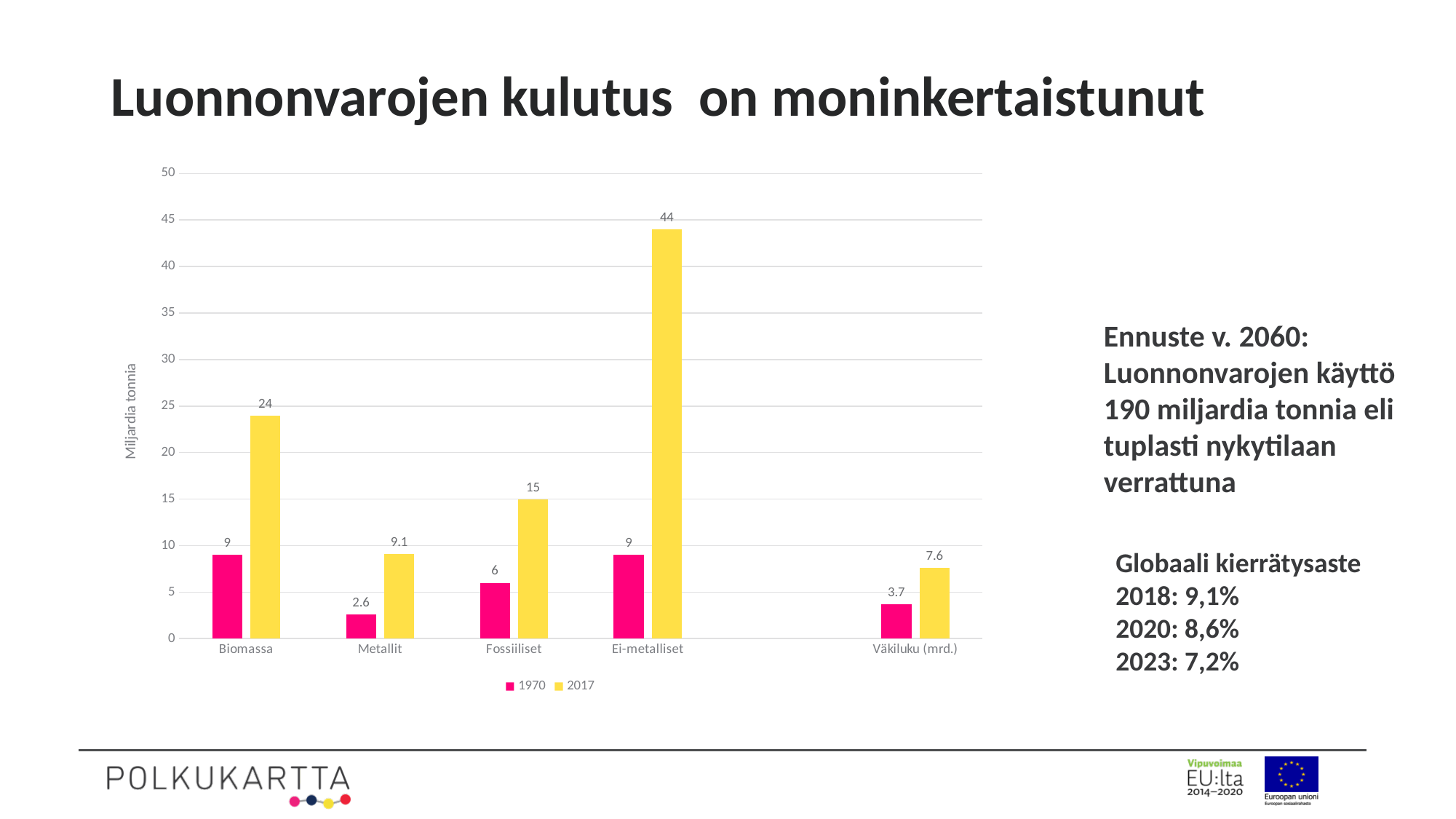
How many series does the legend list? 2 Is the 2017 value for Ei-metalliset greater or less than 40? greater Which is larger: the 2017 value for Fossiiliset or the 2017 value for Metallit? Fossiiliset How many categories are shown on the x axis? 5 What is the difference between the 2017 and 1970 values for Biomassa? 15 What is the label of the vertical axis? Miljardia tonnia Which category has the highest 2017 value? Ei-metalliset What is the 2017 value for Ei-metalliset? 44 Which category has the lowest 1970 value? Metallit What kind of chart is shown on the slide? bar chart What is the 1970 value for Metallit? 2.6 What is the 2017 value for Väkiluku (mrd.)? 7.6